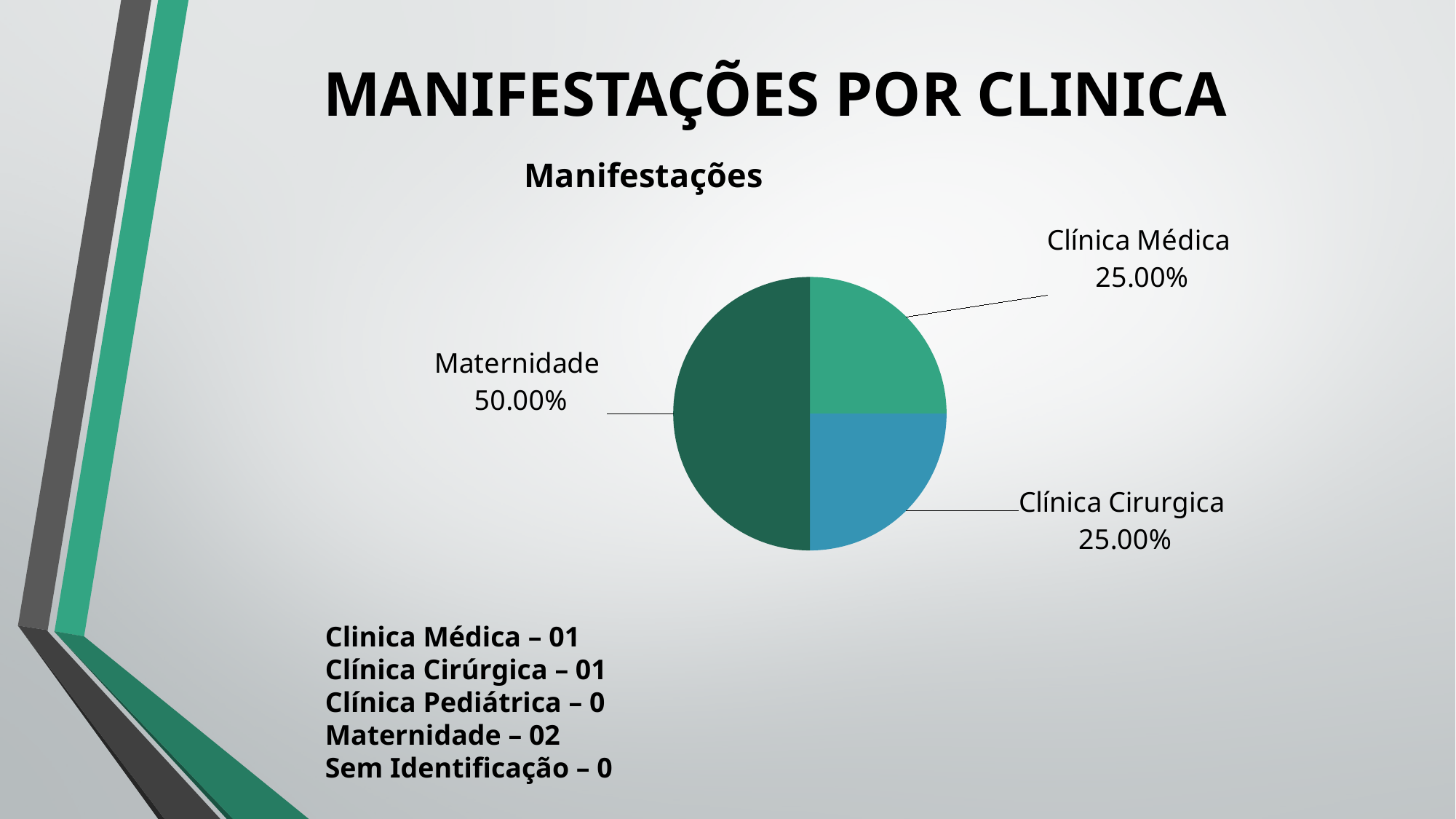
What share of the pie does Clínica Médica represent? 25.00% How many slices does the pie chart have? 3 What colour is the Maternidade slice? dark green What share of the pie does Maternidade represent? 50.00% What share of the pie does Clínica Cirurgica represent? 25.00% Which category has the largest slice of the pie? Maternidade What is the chart's title? Manifestações What kind of chart is shown on the slide? pie chart Which is larger, the slice for Maternidade or the slice for Clínica Médica? Maternidade What is the difference in percentage points between the Maternidade slice and the Clínica Cirurgica slice? 25.00%